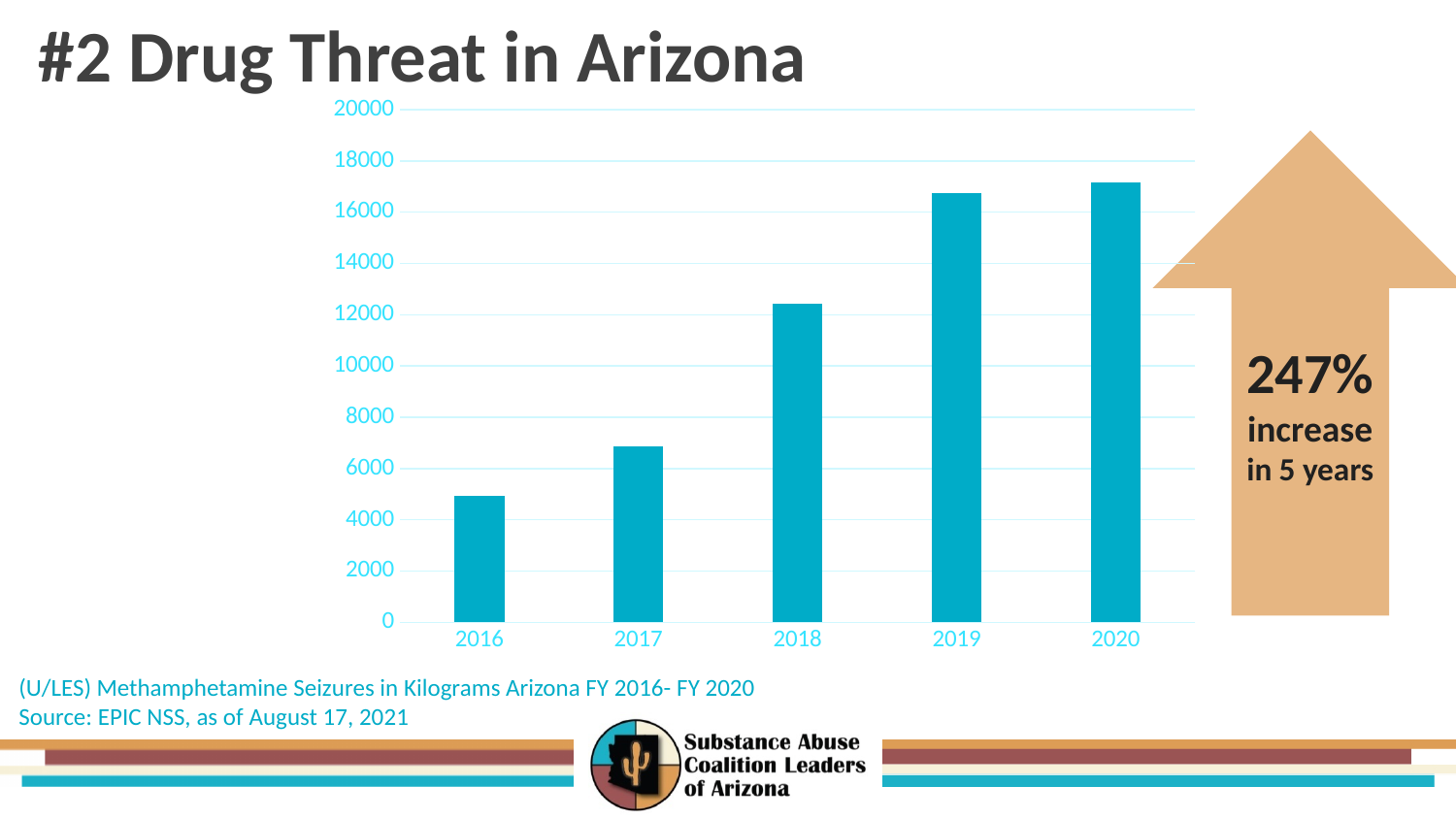
Is the value for 2020 greater or less than 18000? less Is the value for 2019 greater or less than 16000? greater Which year has the highest methamphetamine seizure value? 2020 Do the seizure values rise or fall from 2016 to 2020? rise How many years are plotted on the chart? 5 Is the value for 2016 greater or less than 6000? less Which year has the lowest methamphetamine seizure value? 2016 What percentage increase over 5 years does the arrow on the slide state? 247% Which year has the larger value, 2017 or 2018? 2018 What kind of chart is shown on the slide? bar chart